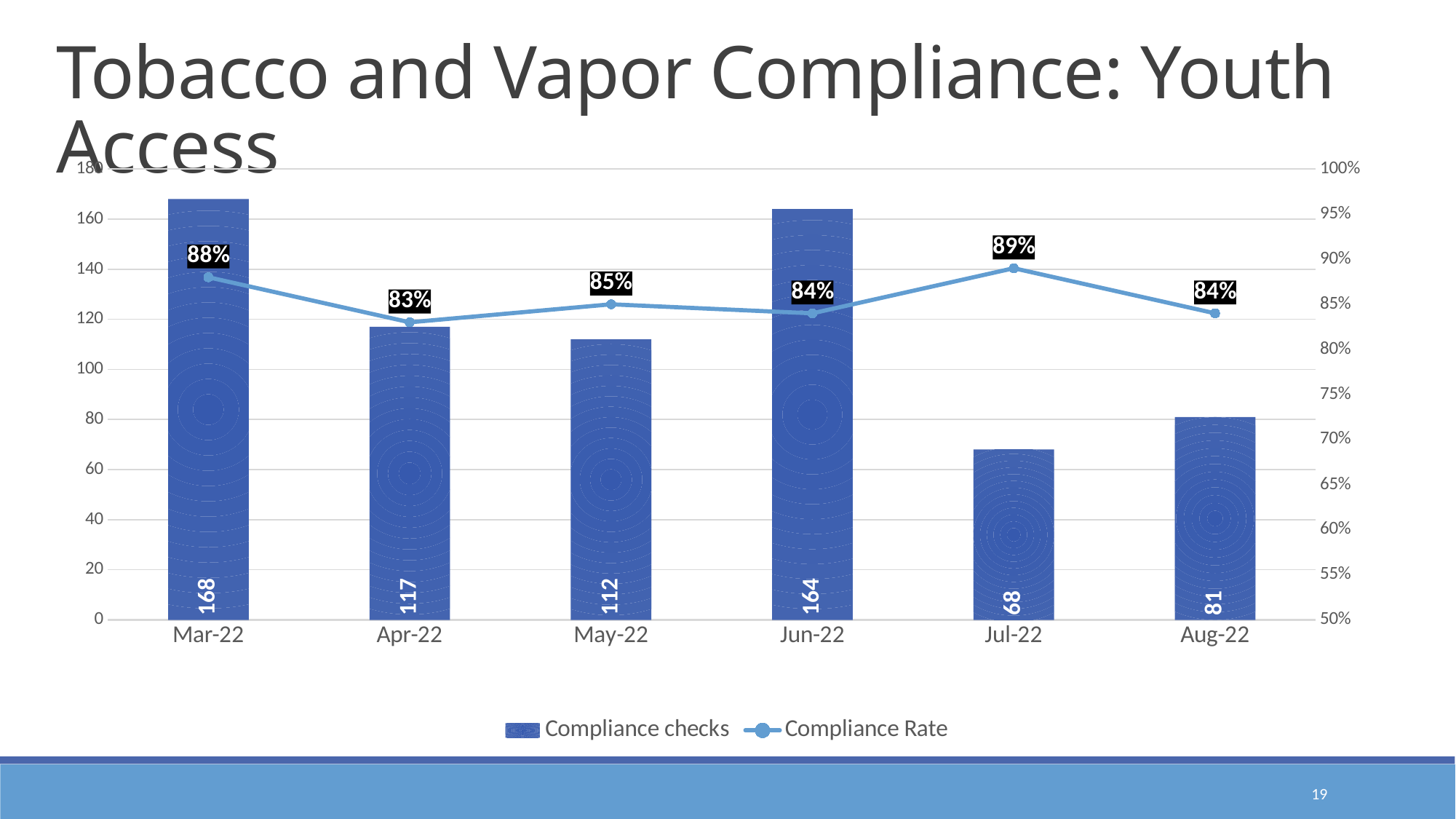
Which month had the lowest compliance rate? Apr-22 Which month had the lowest number of compliance checks? Jul-22 What was the compliance rate in Jul-22? 89% What kind of chart is used to show the compliance checks? Bar chart What are the two series named in the legend? Compliance checks and Compliance Rate Which month had the highest number of compliance checks? Mar-22 Which month had more compliance checks, Apr-22 or May-22? Apr-22 How many months are shown on the x axis? 6 How many series does the legend list? 2 What is the difference in compliance checks between Mar-22 and Jun-22? 4 How many compliance checks were conducted in Aug-22? 81 How many compliance checks were conducted in Mar-22? 168